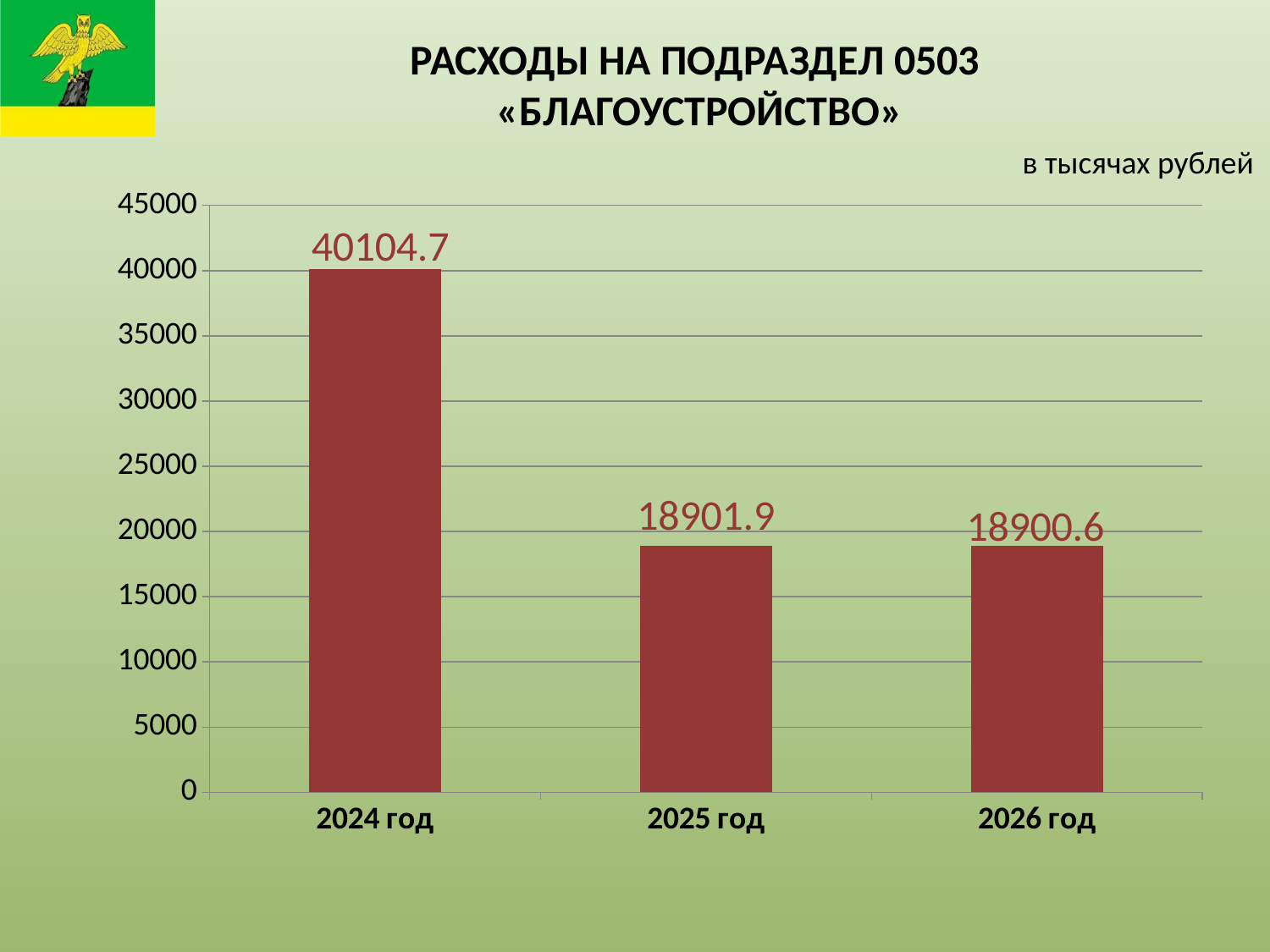
In what units are the values on the chart expressed? в тысячах рублей Is the value for 2024 год greater or less than 35000? greater Which is larger, the value for 2024 год or the value for 2026 год? 2024 год How many years are shown on the chart? 3 Is the value for 2025 год greater or less than 20000? less What is the value for 2025 год? 18901.9 What is the value for 2024 год? 40104.7 What is the difference between the values for 2024 год and 2026 год? 21204.1 What kind of chart is shown on the slide? bar chart Which year has the highest value? 2024 год What is the value for 2026 год? 18900.6 What is the difference between the values for 2024 год and 2025 год? 21202.8